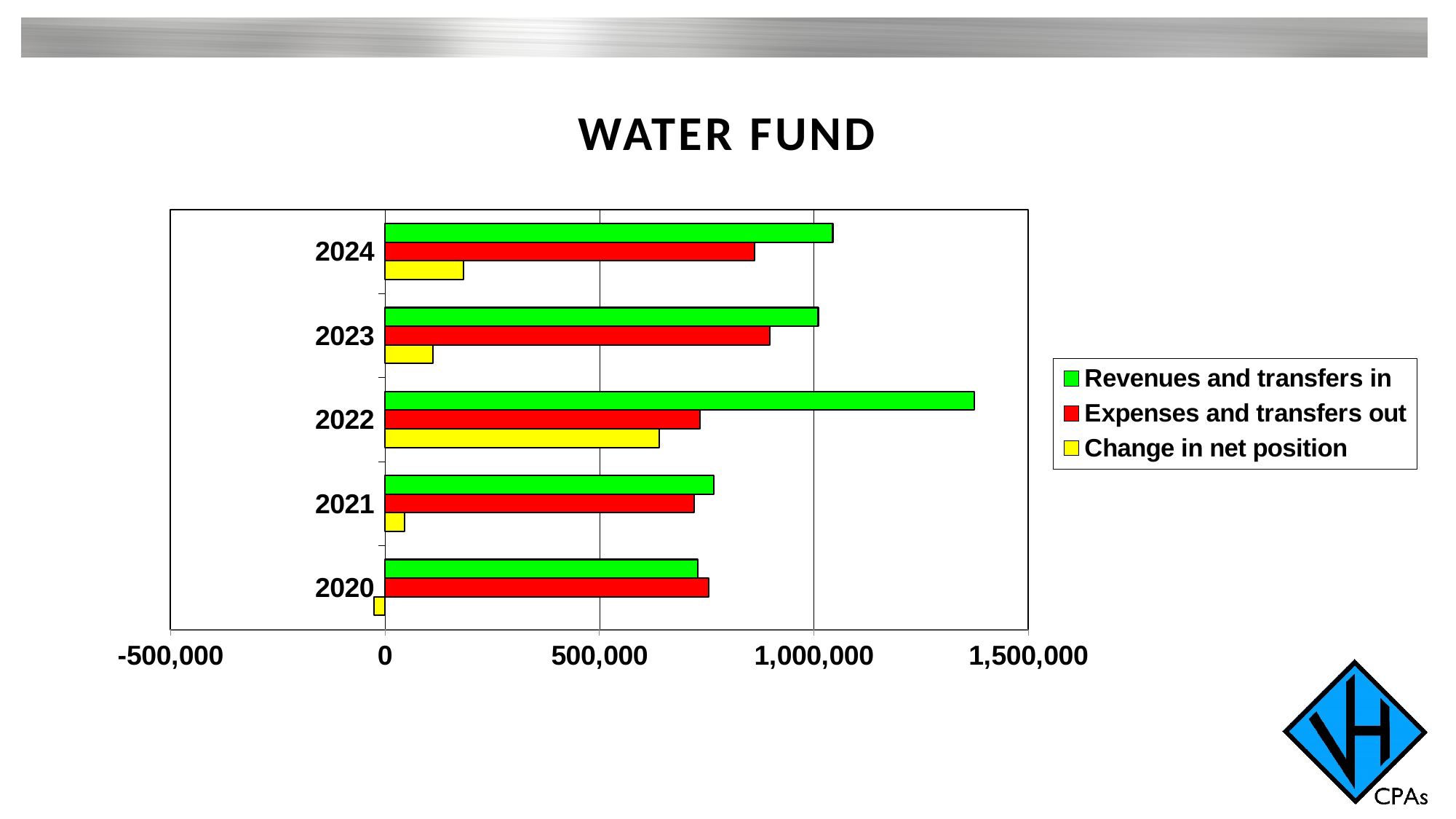
In which year were Revenues and transfers in the highest? 2022 Is the value for Change in net position for 2020 greater or less than 0? less In which year was the Change in net position the lowest? 2020 What kind of chart is shown on the slide? bar chart What is the title of the chart? WATER FUND Is the value for Revenues and transfers in for 2022 greater or less than 1,000,000? greater How many years are shown on the chart? 5 Which series is shown in yellow? Change in net position Is the value for Expenses and transfers out for 2024 greater or less than 1,000,000? less In which year was the Change in net position the highest? 2022 In 2022, which is larger: Revenues and transfers in or Expenses and transfers out? Revenues and transfers in How many series does the legend list? 3